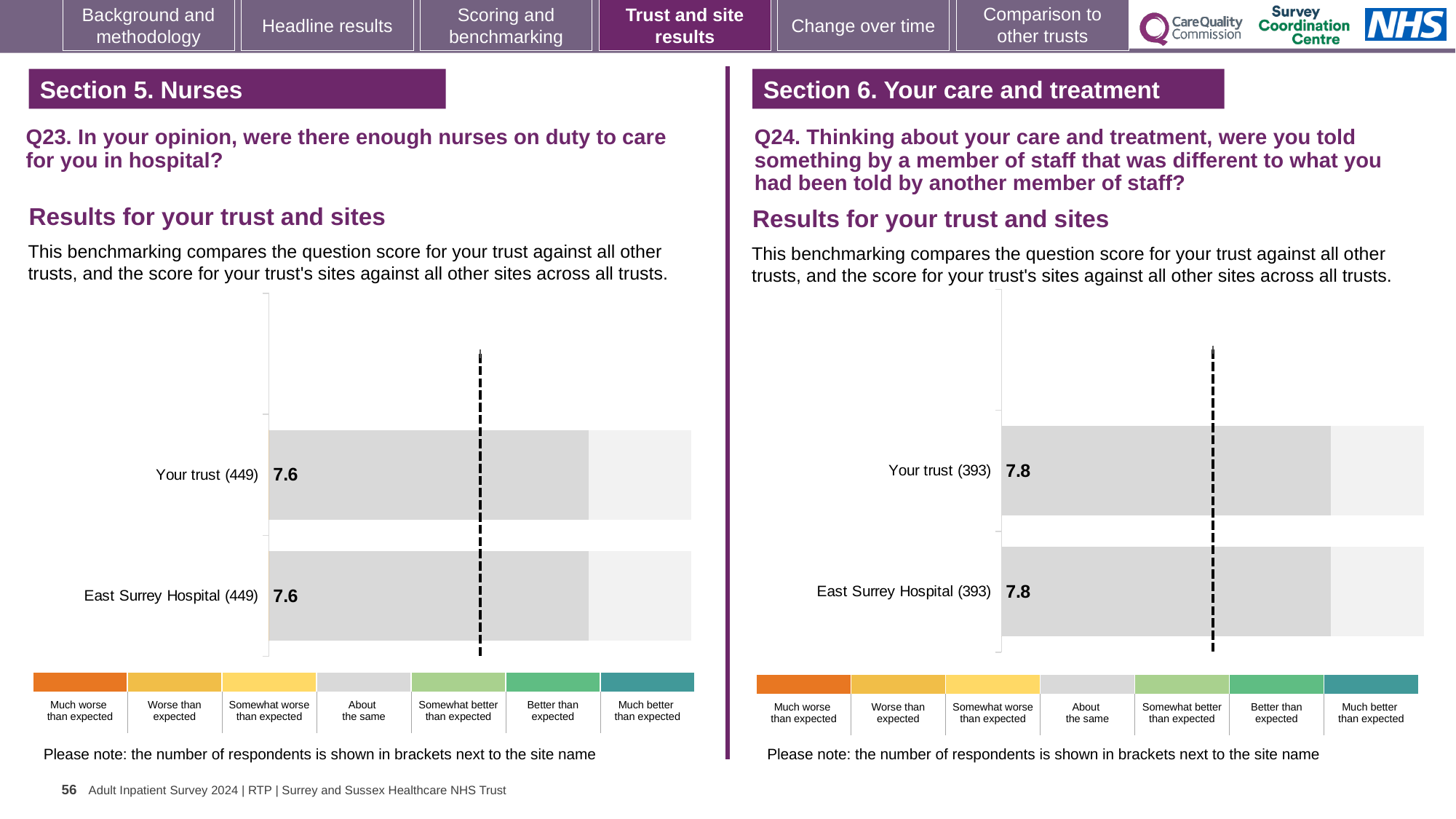
In the Q23 chart on the left, how many respondents are shown in brackets next to Your trust? 449 How many bars are plotted in the Q23 chart on the left? 2 How many bars are plotted in the Q24 chart on the right? 2 In the Q23 chart on the left, what is the score for Your trust? 7.6 In the Q24 chart on the right, what is the score for Your trust? 7.8 In the Q24 chart on the right, how many respondents are shown in brackets next to East Surrey Hospital? 393 What kind of chart is used for the Q23 results on the left? Bar chart In the Q24 chart on the right, what is the score for East Surrey Hospital? 7.8 In the Q24 chart on the right, which benchmark category does the grey shading of the bars fall into according to the legend? About the same In the Q23 chart on the left, what is the score for East Surrey Hospital? 7.6 In the Q23 chart on the left, what is the difference between the scores for Your trust and East Surrey Hospital? 0 In the Q24 chart on the right, what is the difference between the scores for Your trust and East Surrey Hospital? 0